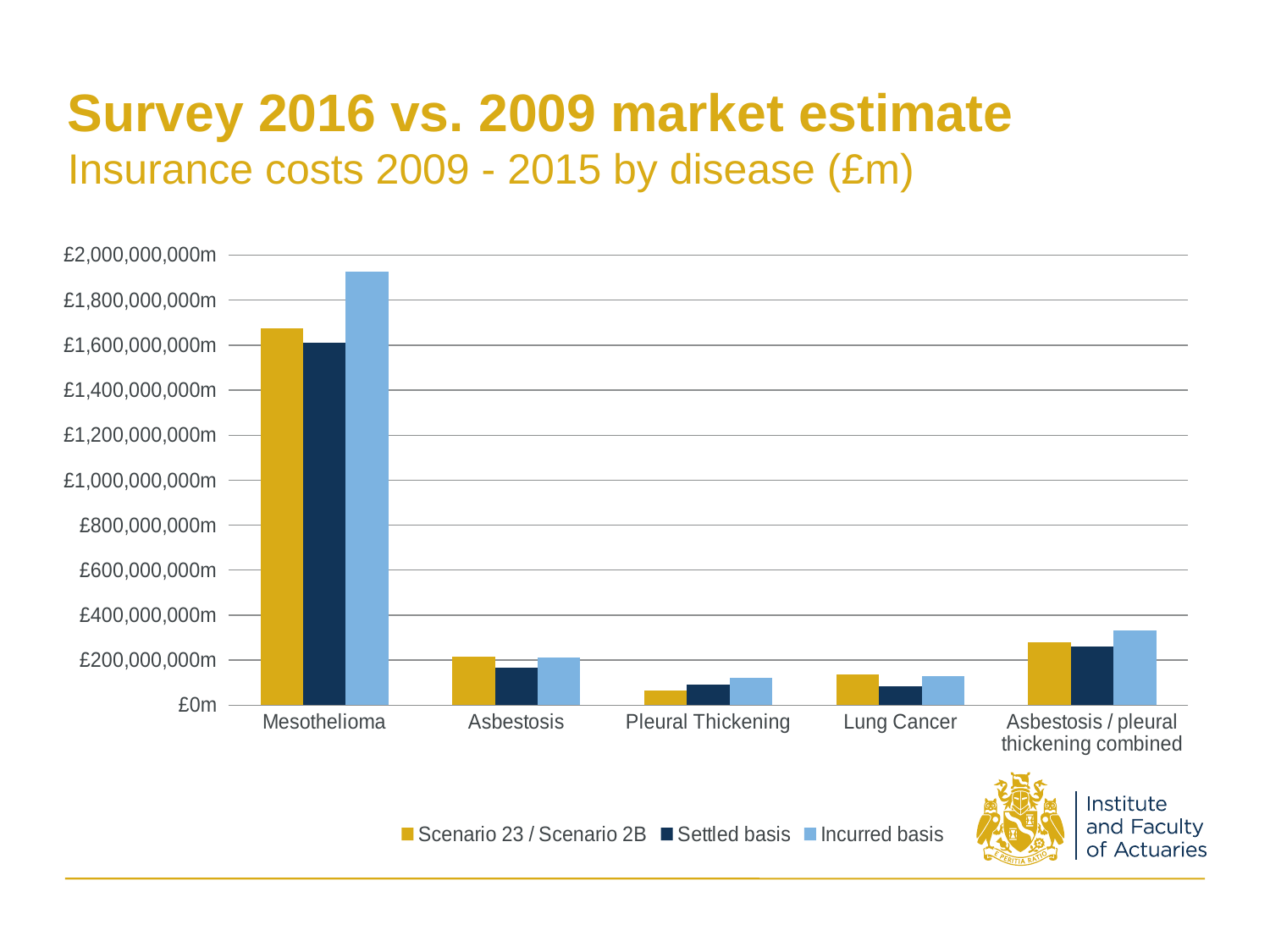
For Mesothelioma, which is larger: the Settled basis value or the Incurred basis value? Incurred basis For Pleural Thickening, which is larger: the Scenario 23 / Scenario 2B value or the Incurred basis value? Incurred basis Is the Incurred basis value for Asbestosis / pleural thickening combined greater or less than £200,000,000m? greater How many disease categories are shown on the x axis? 5 What kind of chart is shown on the slide? bar chart Which disease category has the highest Incurred basis value? Mesothelioma Which disease category has the lowest Scenario 23 / Scenario 2B value? Pleural Thickening Is the Incurred basis value for Mesothelioma greater or less than £1,800,000,000m? greater Which series is shown in light blue in the legend? Incurred basis Is the Scenario 23 / Scenario 2B value for Mesothelioma greater or less than £1,800,000,000m? less How many series does the legend list? 3